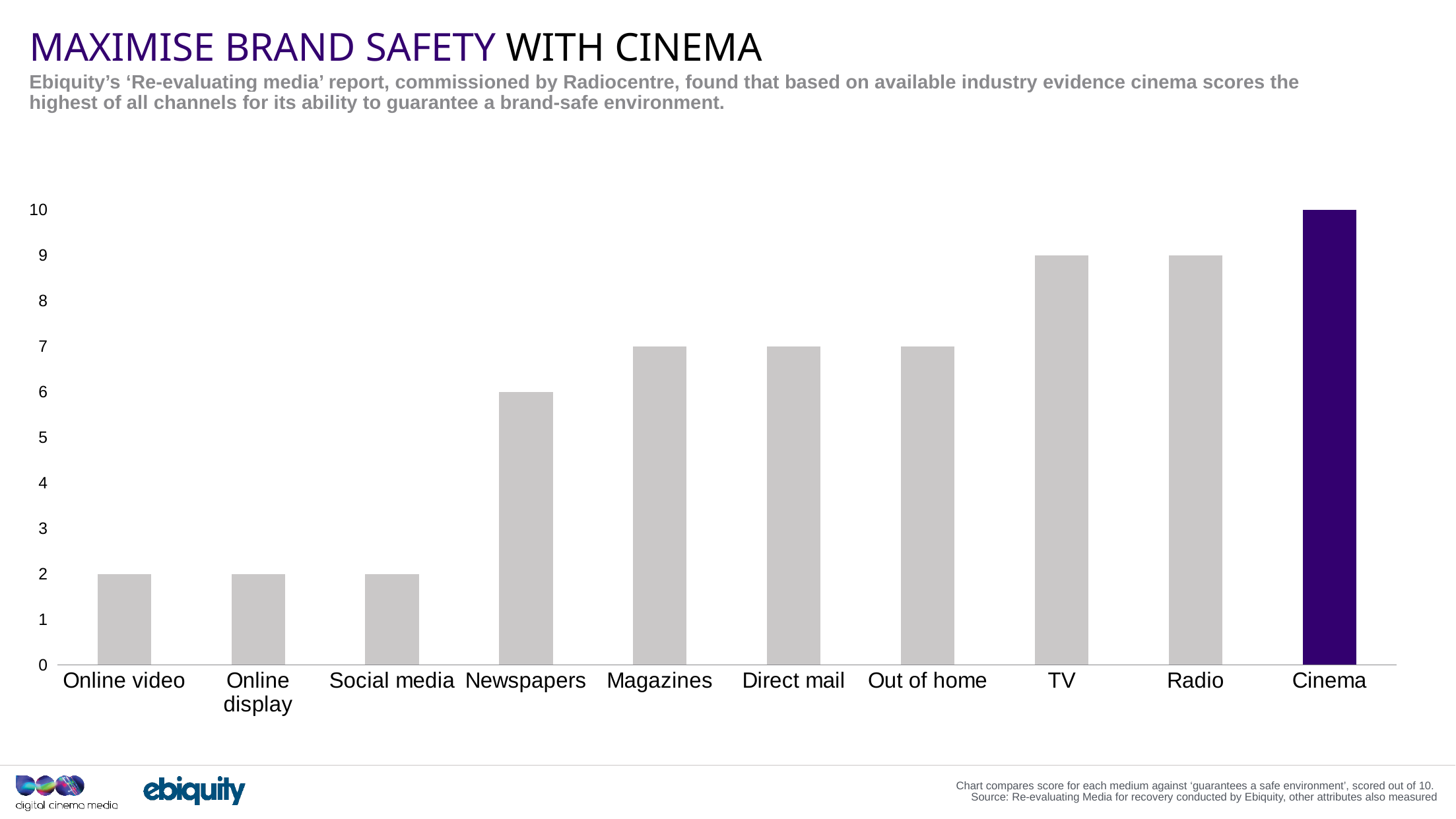
What score does TV reach on the chart? 9 What is the difference between the scores for Magazines and Social media? 5 What is the difference between the scores for Cinema and Radio? 1 Which medium has the highest score on the chart? Cinema Is the value for Out of home greater or less than 5? greater Which has a higher score, Newspapers or Direct mail? Direct mail What type of chart is shown on the slide? bar chart Which bar on the chart is coloured dark purple rather than grey? Cinema What score does Online video reach on the chart? 2 How many media categories are shown on the chart? 10 What score does Newspapers reach on the chart? 6 What score does Cinema reach on the chart? 10